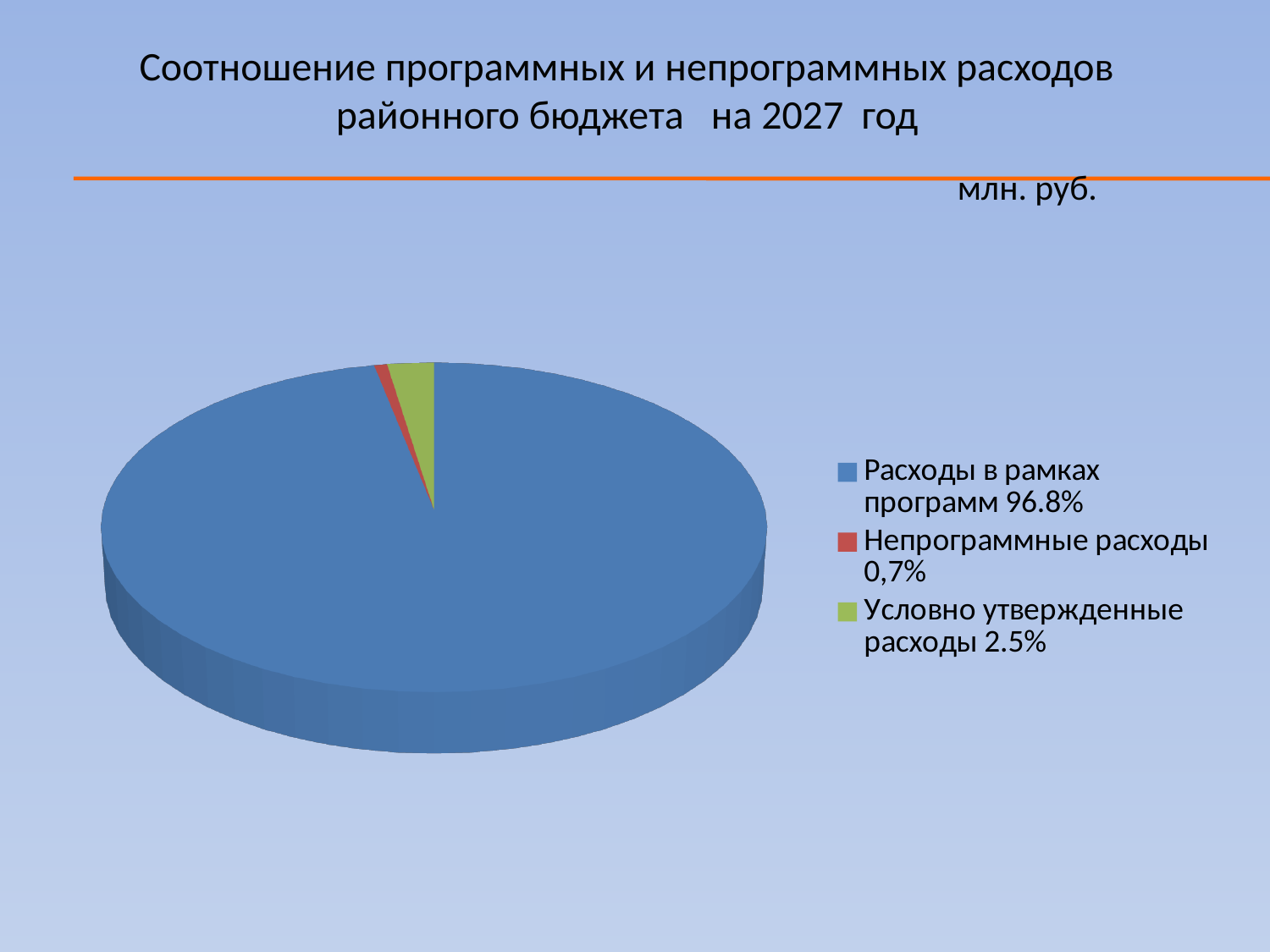
Which is larger: 'Условно утвержденные расходы' or 'Непрограммные расходы'? Условно утвержденные расходы What percentage is shown in the legend for 'Расходы в рамках программ'? 96.8% How many slices does the pie chart have? 3 Which category has the smallest share of the pie? Непрограммные расходы What kind of chart is shown on the slide? pie chart Which category has the largest share of the pie? Расходы в рамках программ What colour is the slice for 'Расходы в рамках программ'? blue What colour is the slice for 'Условно утвержденные расходы'? green What percentage is shown in the legend for 'Непрограммные расходы'? 0,7% How many entries does the legend list? 3 What percentage is shown in the legend for 'Условно утвержденные расходы'? 2.5% Is the share for 'Расходы в рамках программ' greater or less than 90%? greater